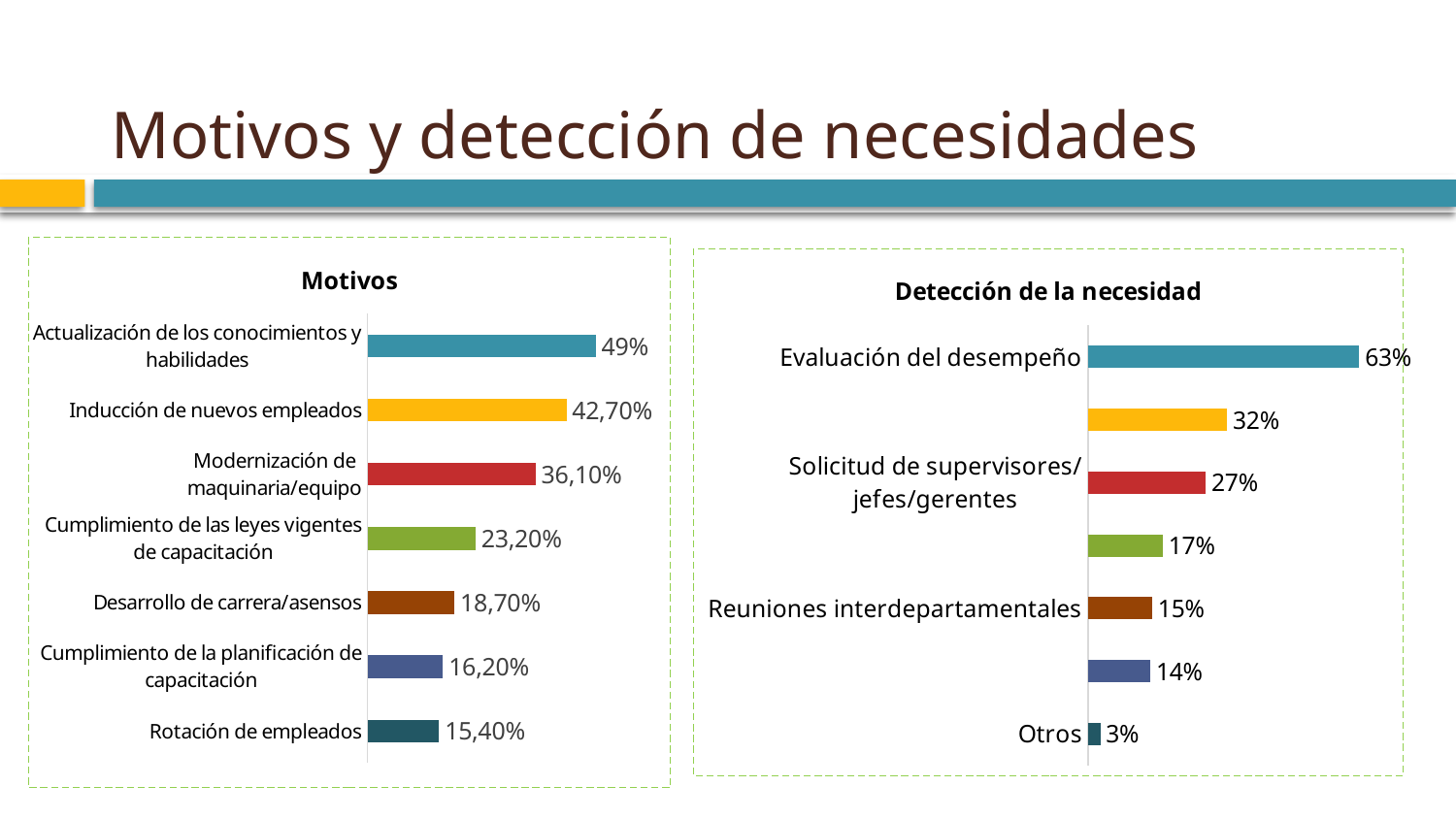
In the 'Detección de la necesidad' chart, what is the difference between 'Evaluación del desempeño' and 'Solicitud de supervisores/jefes/gerentes'? 36% What type of chart is the 'Detección de la necesidad' chart? Bar chart In the 'Motivos' chart, which is larger: 'Desarrollo de carrera/asensos' or 'Cumplimiento de la planificación de capacitación'? Desarrollo de carrera/asensos In the 'Motivos' chart, what is the value for 'Inducción de nuevos empleados'? 42,70% In the 'Motivos' chart, which category has the lowest value? Rotación de empleados In the 'Motivos' chart, what is the difference between 'Modernización de maquinaria/equipo' and 'Cumplimiento de las leyes vigentes de capacitación'? 12,90% In the 'Motivos' chart, what is the value for 'Rotación de empleados'? 15,40% How many categories are shown in the 'Motivos' chart? 7 In the 'Detección de la necesidad' chart, what is the value for 'Reuniones interdepartamentales'? 15% In the 'Motivos' chart, which category has the highest value? Actualización de los conocimientos y habilidades In the 'Detección de la necesidad' chart, what is the value for 'Evaluación del desempeño'? 63% In the 'Detección de la necesidad' chart, which category has the lowest value? Otros